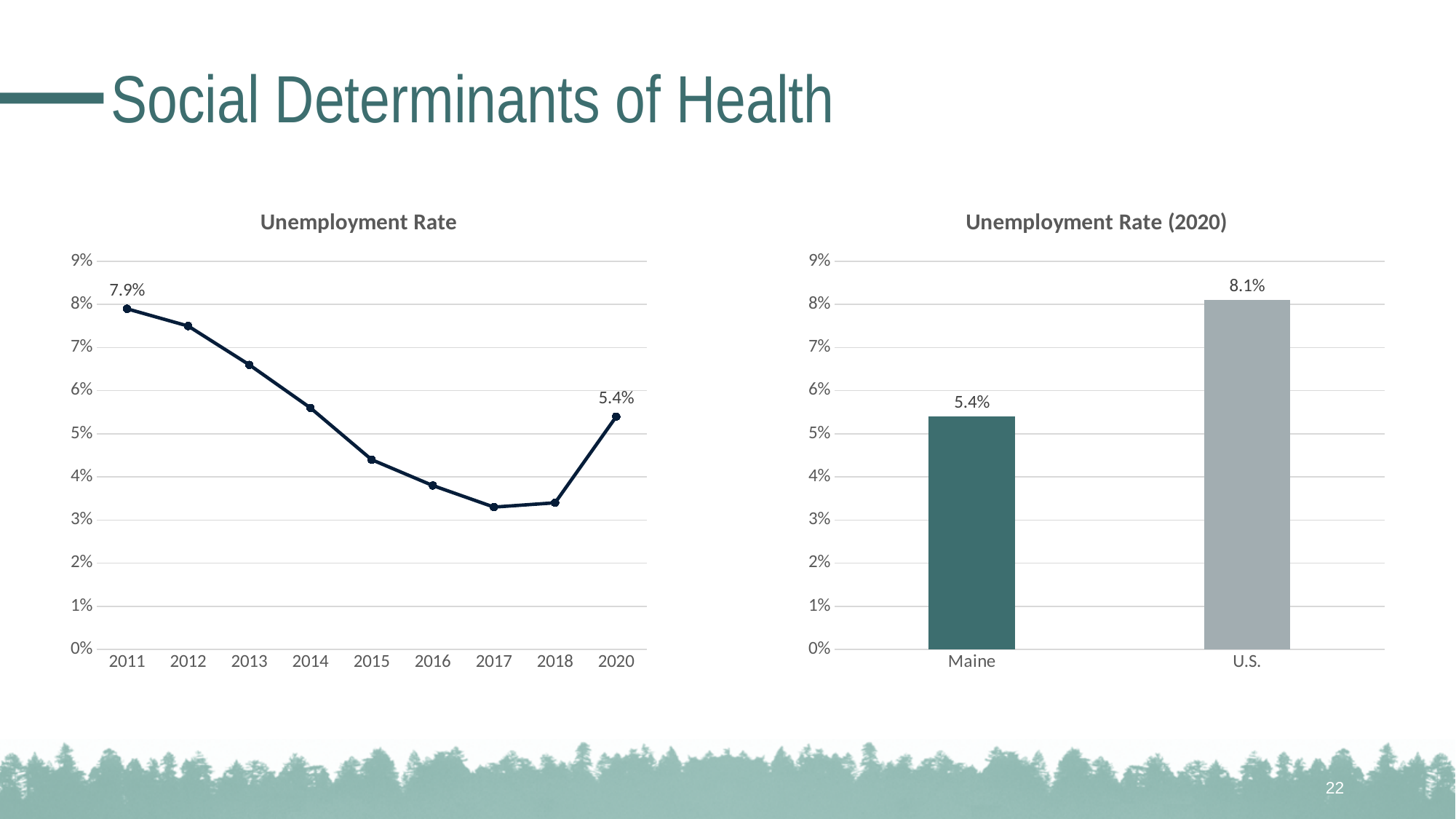
In the 'Unemployment Rate' chart, does the unemployment rate rise or fall from 2011 to 2017? fall In the 'Unemployment Rate' chart, which year has the highest unemployment rate? 2011 In the 'Unemployment Rate' chart, which year has the lowest unemployment rate? 2017 In the 'Unemployment Rate' chart, what is the value for 2020? 5.4% In the 'Unemployment Rate' chart, is the value for 2015 greater or less than 5%? less In the 'Unemployment Rate (2020)' chart, what is the value for the U.S.? 8.1% In the 'Unemployment Rate' chart, what is the value for 2011? 7.9% What kind of chart is the 'Unemployment Rate' chart on the left? line chart In the 'Unemployment Rate' chart, how many years are plotted on the x axis? 9 In the 'Unemployment Rate' chart, what is the difference between the 2011 and 2020 values? 2.5% In the 'Unemployment Rate (2020)' chart, what is the difference between the U.S. and Maine values? 2.7% In the 'Unemployment Rate (2020)' chart, which is larger, Maine or U.S.? U.S.